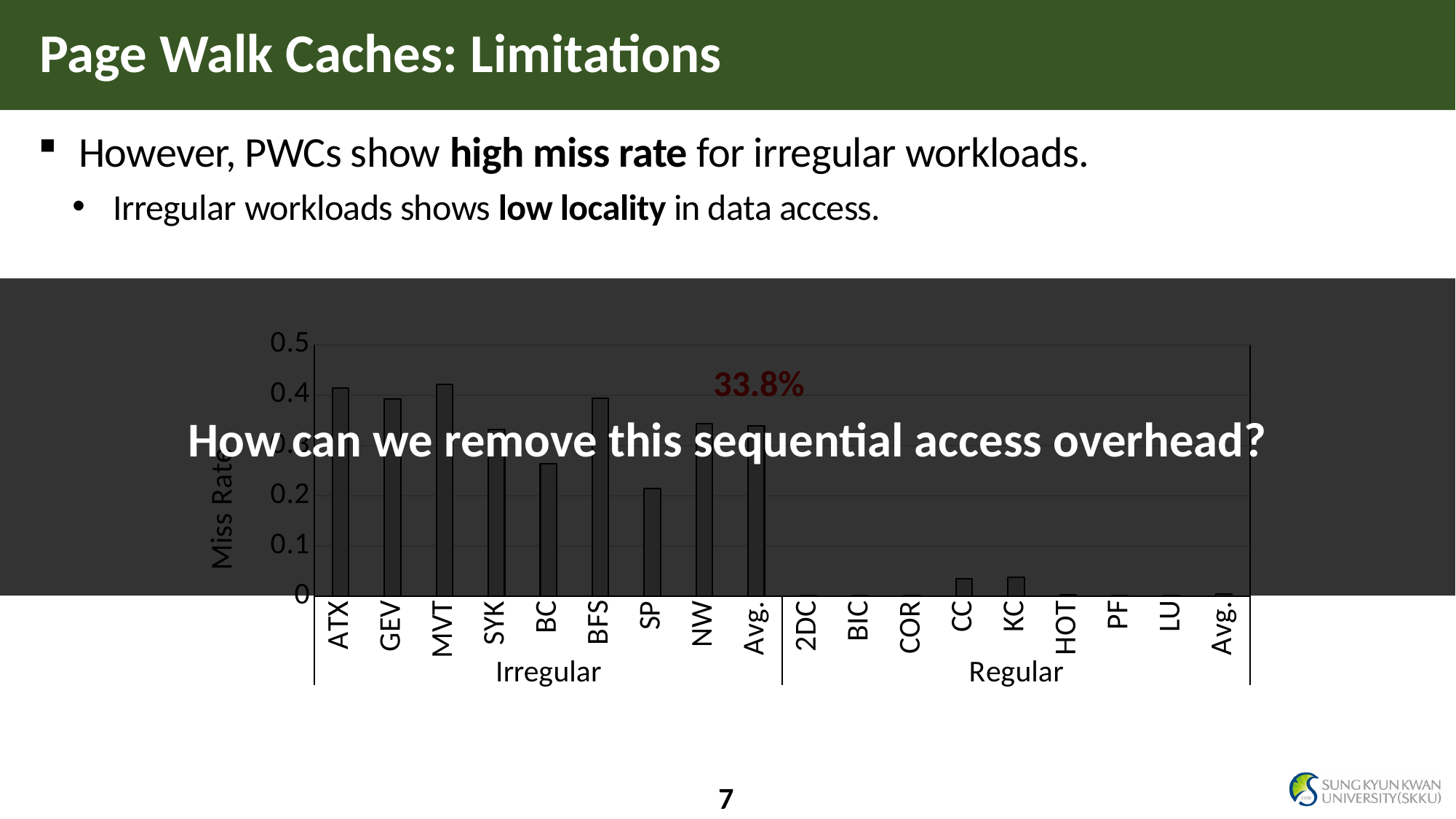
Is the miss rate for CC greater or less than 0.1? less How many workload categories are plotted along the x axis? 18 Which has the higher miss rate, SP or BFS? BFS Is the miss rate for SP greater or less than 0.3? less Is the miss rate for MVT greater or less than 0.4? greater What kind of chart is shown on the slide? bar chart Among the Irregular workloads, which has the lowest miss rate? SP What is the label of the y axis? Miss Rate What are the two workload groups labelled on the x axis? Irregular and Regular What value is printed as a data label on the chart? 33.8% Which workload group's Avg. bar is labelled 33.8%? Irregular Which has the higher miss rate, ATX or KC? ATX